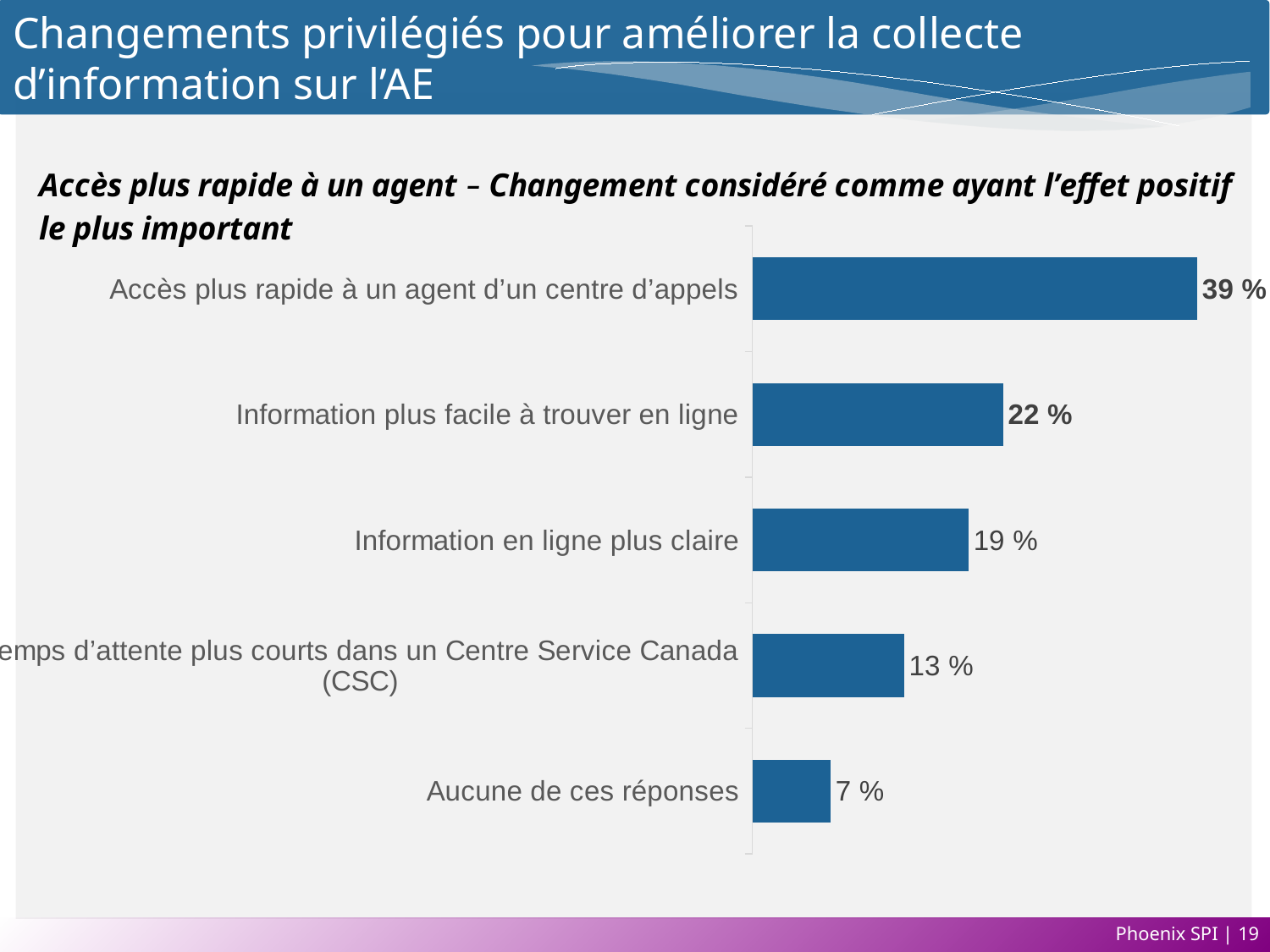
What is the value for the category about shorter wait times at a Centre Service Canada (CSC)? 13 % What is the value for "Information plus facile à trouver en ligne"? 22 % Which category has the lowest value? Aucune de ces réponses What is the value for "Accès plus rapide à un agent d'un centre d'appels"? 39 % What is the value for "Information en ligne plus claire"? 19 % What kind of chart is shown on the slide? Bar chart Which category has the highest value? Accès plus rapide à un agent d'un centre d'appels What is the difference between the values for "Information en ligne plus claire" and "Aucune de ces réponses"? 12 % How many categories are shown in the chart? 5 What is the value for "Aucune de ces réponses"? 7 % Which is larger: the value for "Information plus facile à trouver en ligne" or "Information en ligne plus claire"? Information plus facile à trouver en ligne What is the difference between the values for "Accès plus rapide à un agent d'un centre d'appels" and "Information plus facile à trouver en ligne"? 17 %